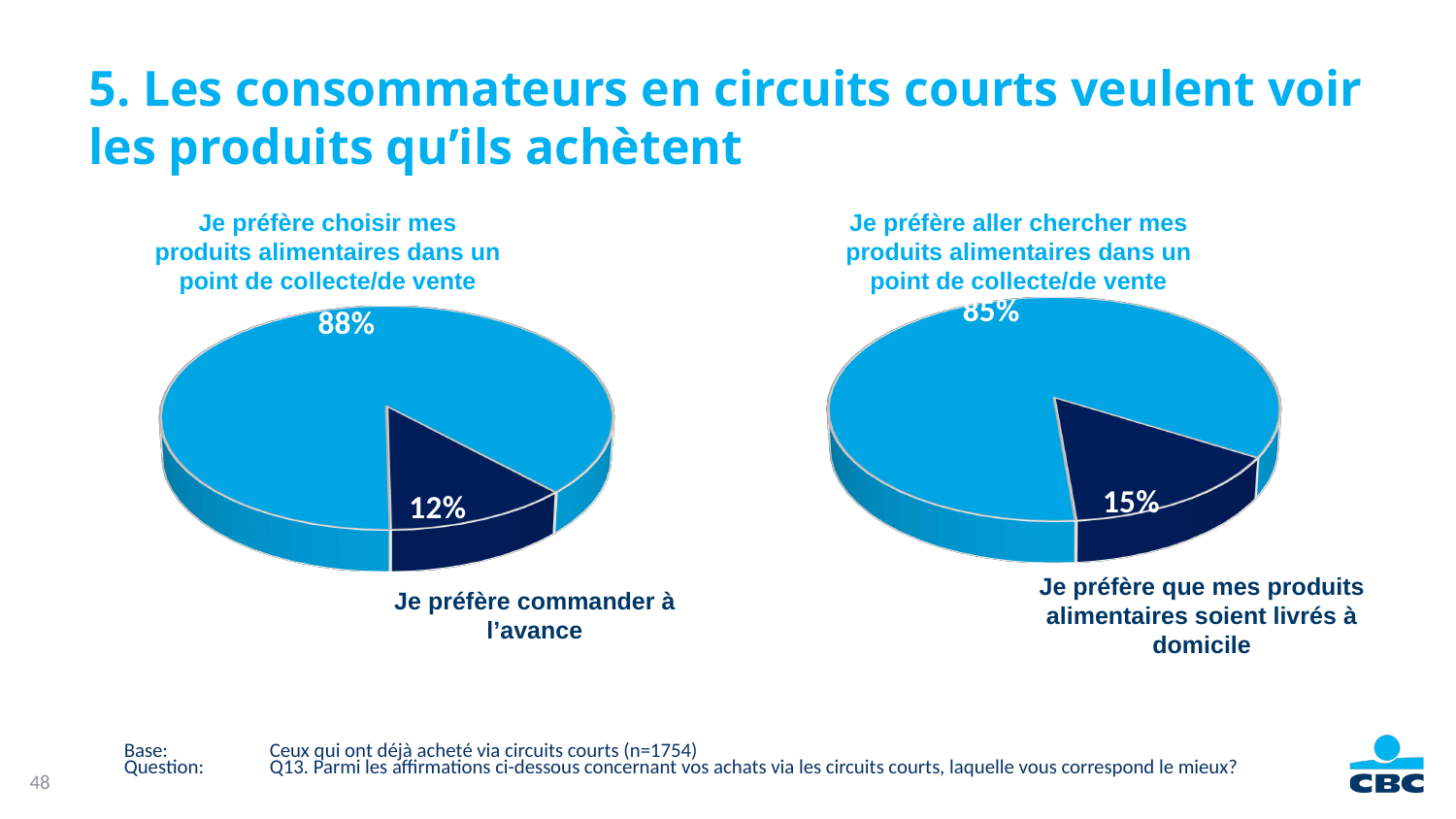
In the left pie chart, which option has the largest share? Je préfère choisir mes produits alimentaires dans un point de collecte/de vente What type of chart is used on the left side of the slide? Pie chart How many slices does the right pie chart have? 2 How many pie charts are shown on the slide? 2 In the left pie chart, what share of respondents prefer to order in advance ("Je préfère commander à l'avance")? 12% In the right pie chart, which option has the smallest share? Je préfère que mes produits alimentaires soient livrés à domicile In the right pie chart, what is the difference in percentage points between the two slices? 70 percentage points In the right pie chart, what share of respondents prefer to go and pick up their food products at a collection/sales point ("Je préfère aller chercher mes produits alimentaires dans un point de collecte/de vente")? 85% In the left pie chart, what is the difference in percentage points between the two slices? 76 percentage points Which is larger: the share for "Je préfère commander à l'avance" in the left chart or the share for "Je préfère que mes produits alimentaires soient livrés à domicile" in the right chart? Je préfère que mes produits alimentaires soient livrés à domicile (15%) In the right pie chart, what share of respondents prefer to have their food products delivered at home ("Je préfère que mes produits alimentaires soient livrés à domicile")? 15%